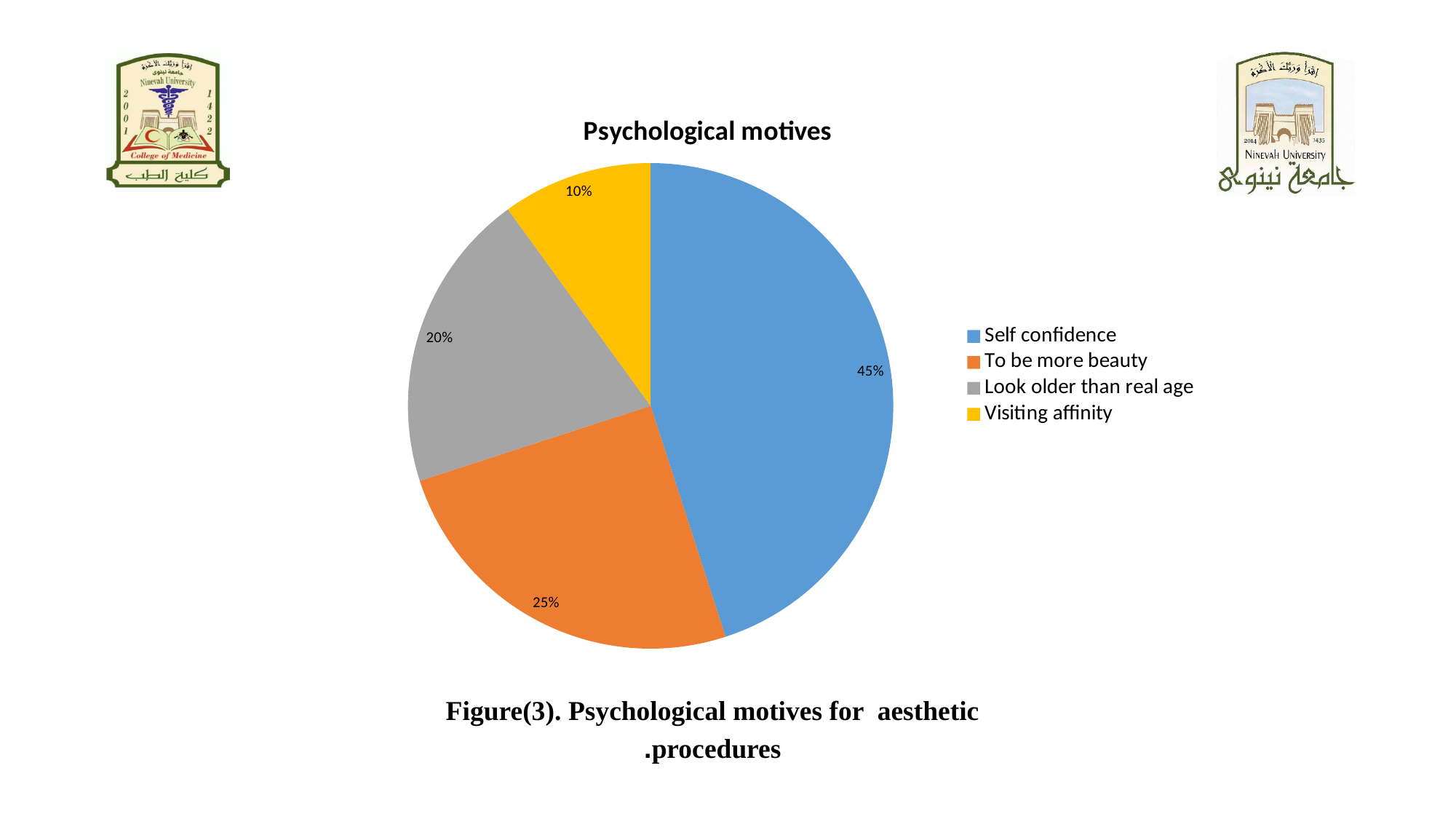
Which category has the largest slice of the pie? Self confidence How many categories are shown in the pie chart? 4 What is the difference in percentage points between Self confidence and To be more beauty? 20 What percentage is labelled for Visiting affinity? 10% What share of the pie does Self confidence account for? 45% What is the value for Look older than real age? 20% Which colour represents To be more beauty in the legend? Orange Which category has the smallest slice of the pie? Visiting affinity Which is larger, Look older than real age or Visiting affinity? Look older than real age What is the title of the chart? Psychological motives What kind of chart is shown on the slide? Pie chart What percentage is shown for To be more beauty? 25%